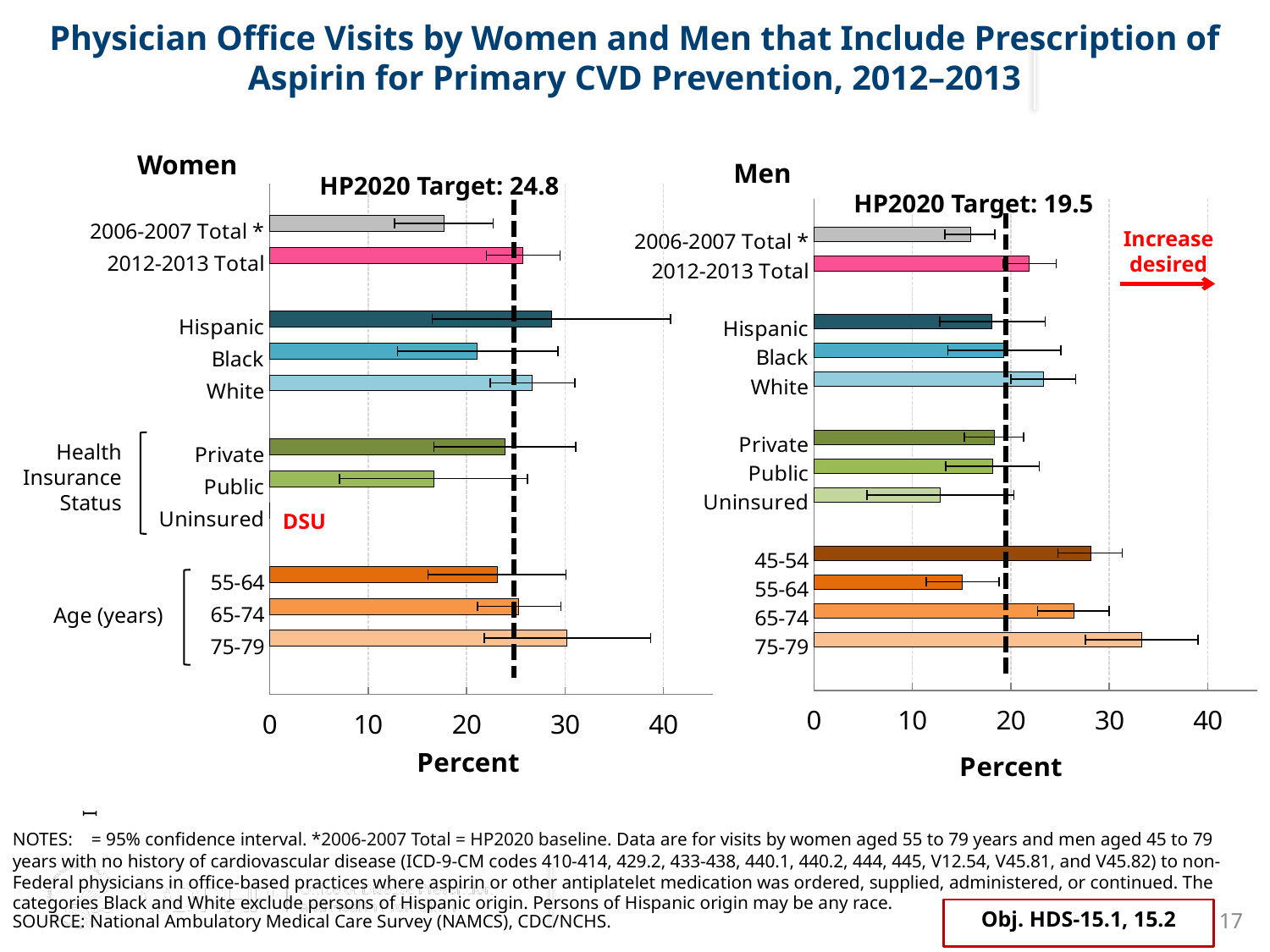
On the Men chart, what is the HP2020 Target value shown? 19.5 On the Men chart, is the value for Uninsured greater or less than 20? less On the Women chart, what is shown in place of a bar for the Uninsured category? DSU On the Women chart, what is the HP2020 Target value shown? 24.8 On the Women chart, is the value for Hispanic greater or less than 20? greater On the Men chart, which age group has the lowest value? 55-64 On the Men chart, is the value for ages 75-79 greater or less than 30? greater How many age groups are plotted on the Men chart? 4 On the Men chart, which is larger, the value for ages 45-54 or ages 55-64? 45-54 On the Men chart, which age group has the highest value? 75-79 What kind of chart is used on this slide for the Women and Men panels? bar chart